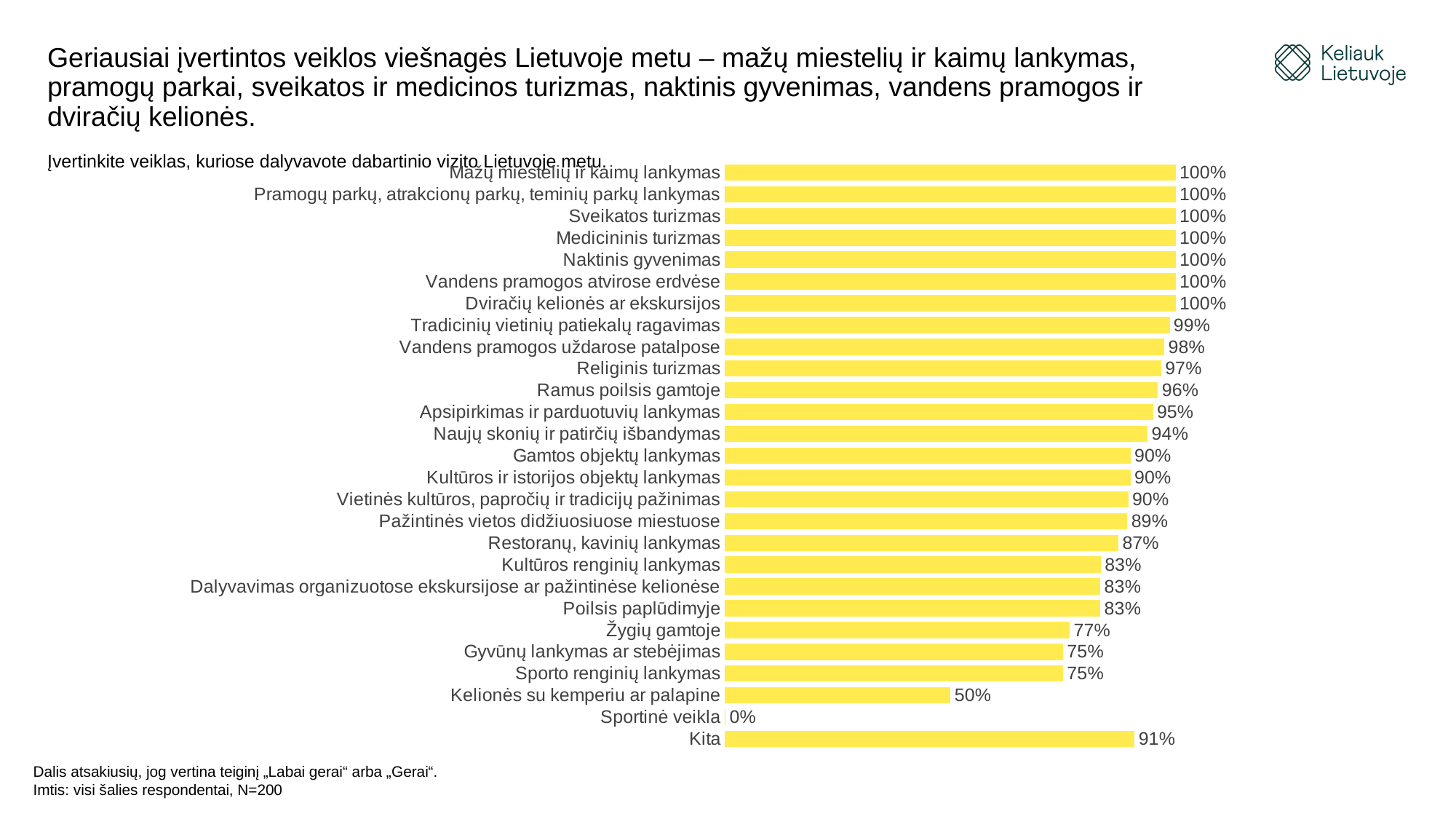
How many categories are shown in the chart? 27 What is the value for Religinis turizmas? 97% Which category has the lowest value? Sportinė veikla Which is larger: the value for Gamtos objektų lankymas or the value for Sporto renginių lankymas? Gamtos objektų lankymas What is the value for Žygių gamtoje? 77% What kind of chart is shown on the slide? Bar chart What is the value for Kita? 91% What is the difference between the values for Tradicinių vietinių patiekalų ragavimas and Kelionės su kemperiu ar palapine? 49% What is the value for Kelionės su kemperiu ar palapine? 50% What colour are the bars in the chart? Yellow What is the difference between the values for Restoranų, kavinių lankymas and Poilsis paplūdimyje? 4% How many categories have a value of 100%? 7